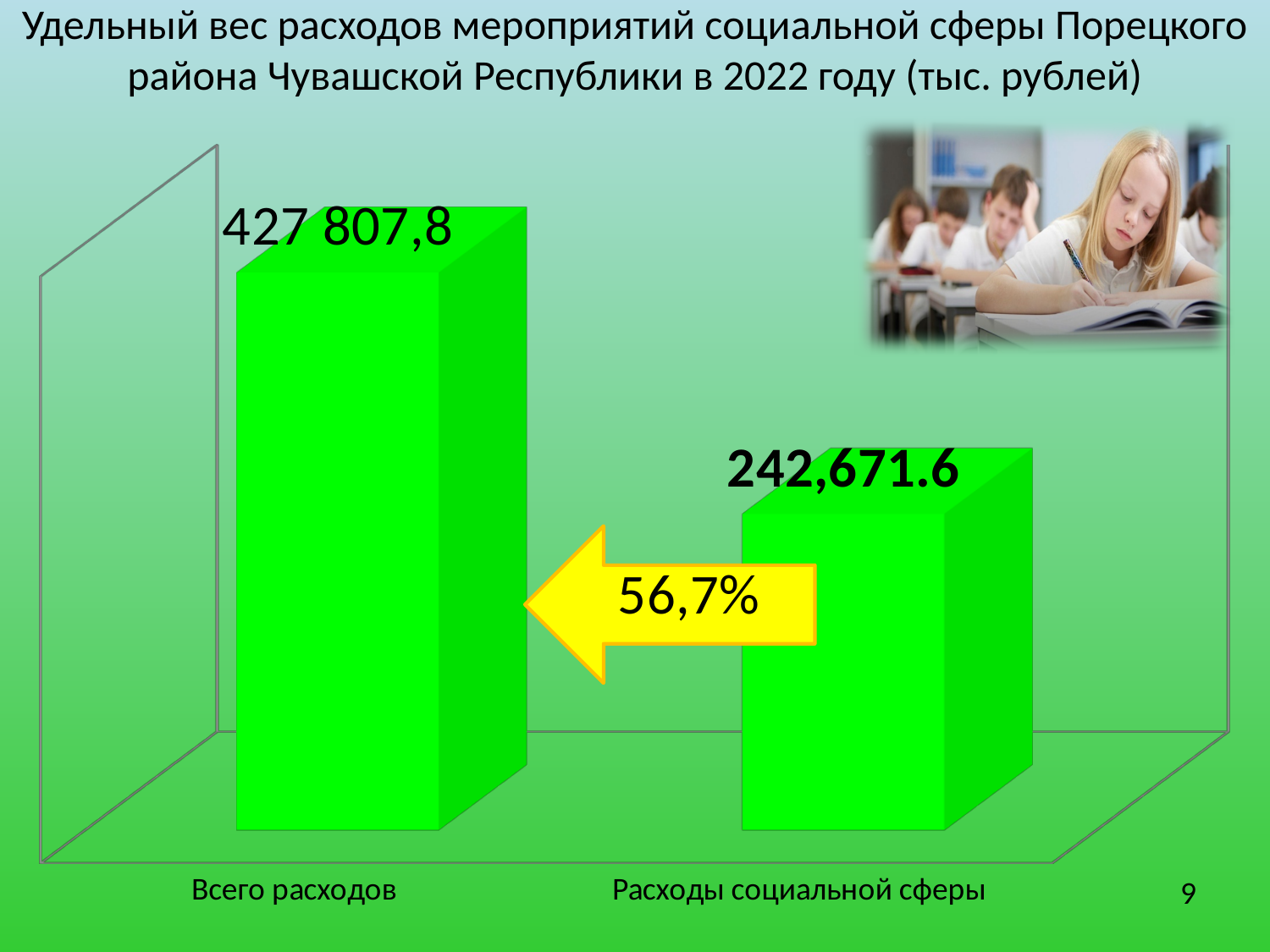
Which category has the lowest value? Расходы социальной сферы Which category has the highest value? Всего расходов What percentage is written on the yellow arrow between the bars? 56,7% What colour are the bars in the chart? Green What is the value shown for Всего расходов? 427 807,8 What year does the chart title refer to? 2022 What is the difference between the value for Всего расходов and the value for Расходы социальной сферы? 185 136,2 What is the value shown for Расходы социальной сферы? 242,671.6 Which is larger: Всего расходов or Расходы социальной сферы? Всего расходов What kind of chart is shown on the slide? Bar chart How many bars are shown in the chart? 2